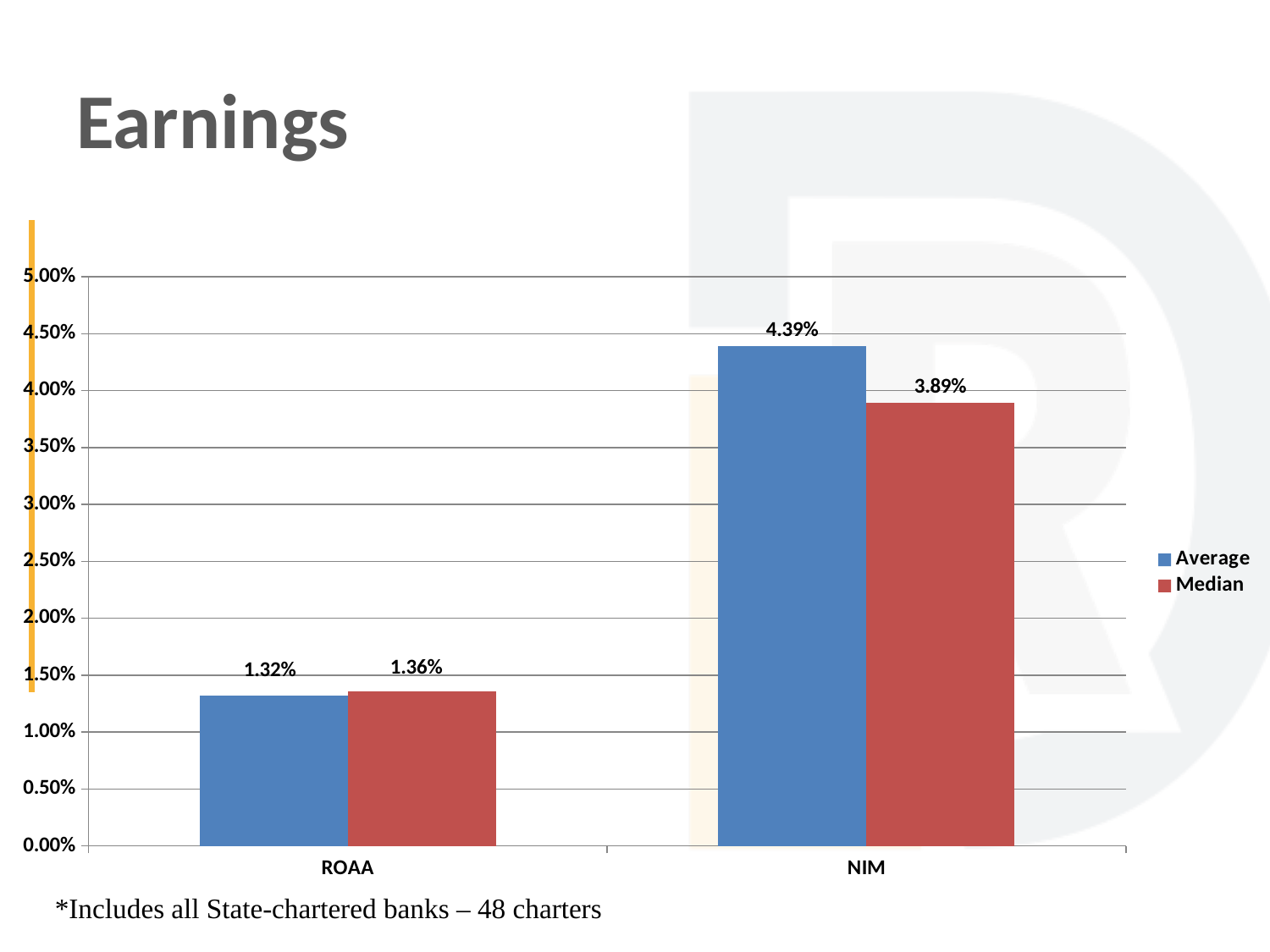
Is the Average value for NIM greater or less than 4.00%? greater What is the Median value for ROAA? 1.36% What is the Median value for NIM? 3.89% Which category has the highest Average value? NIM What is the difference between the Average and Median values for NIM? 0.50% How many categories are shown on the x axis? 2 What is the Average value for NIM? 4.39% For ROAA, which is larger, the Average or the Median? Median What kind of chart is shown on the slide? bar chart What is the Average value for ROAA? 1.32% Which category has the lowest Median value? ROAA How many series does the legend list? 2